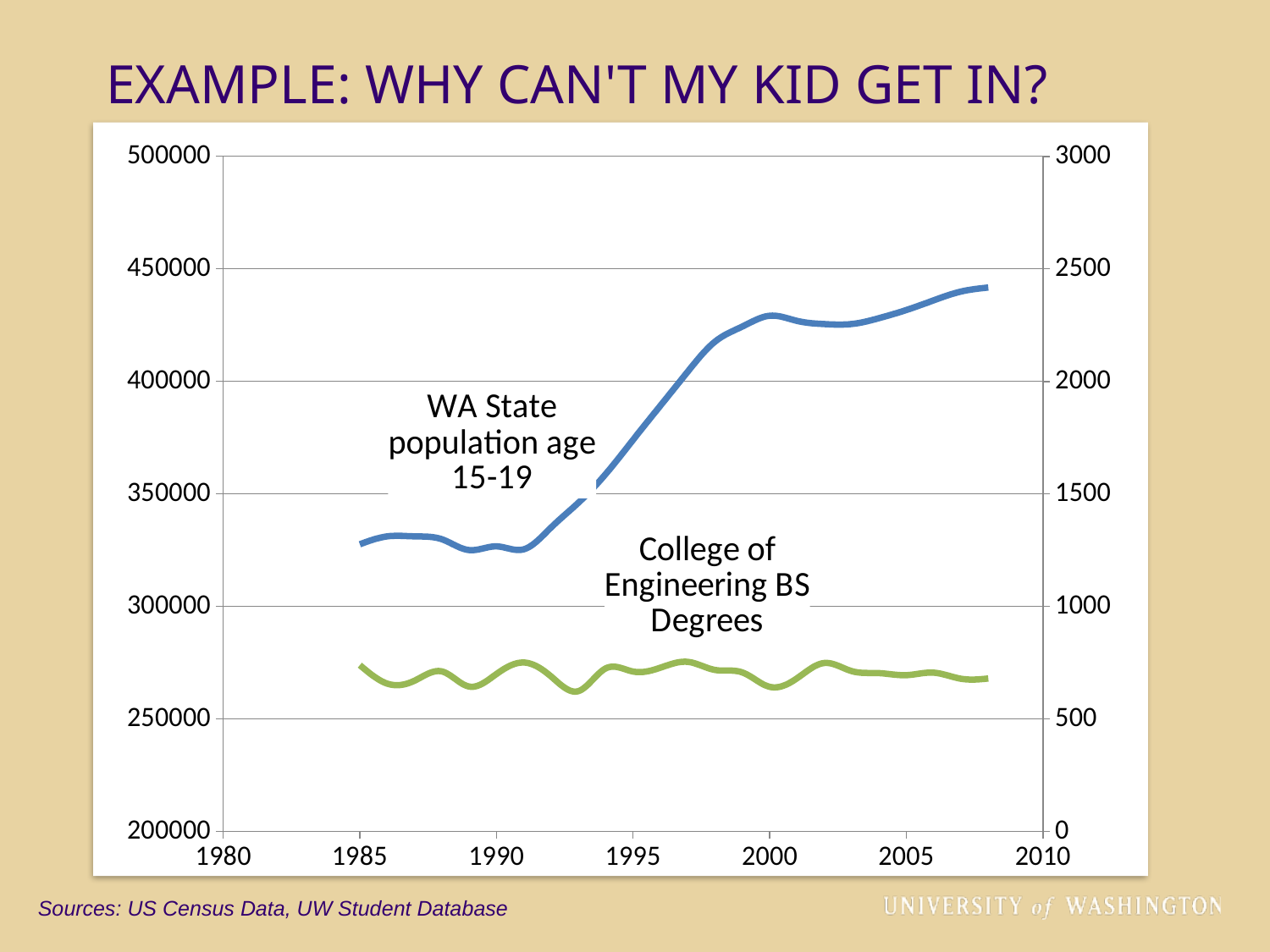
What is the title of the slide containing the chart? EXAMPLE: WHY CAN'T MY KID GET IN? Is the WA State population age 15-19 value in 1985 greater or less than 350000? less Which is larger for WA State population age 15-19: the value in 1985 or the value in 2008? 2008 Does the WA State population age 15-19 line rise or fall overall from 1985 to 2008? rise Does the College of Engineering BS Degrees line rise sharply, fall sharply, or stay roughly flat from 1985 to 2008? roughly flat Is the WA State population age 15-19 value in 2005 greater or less than 400000? greater On the right-hand axis, is the College of Engineering BS Degrees value in 1985 greater or less than 500? greater How many data series are plotted on the chart? 2 Which series is plotted with the blue line? WA State population age 15-19 What kind of chart is shown on the slide? line chart